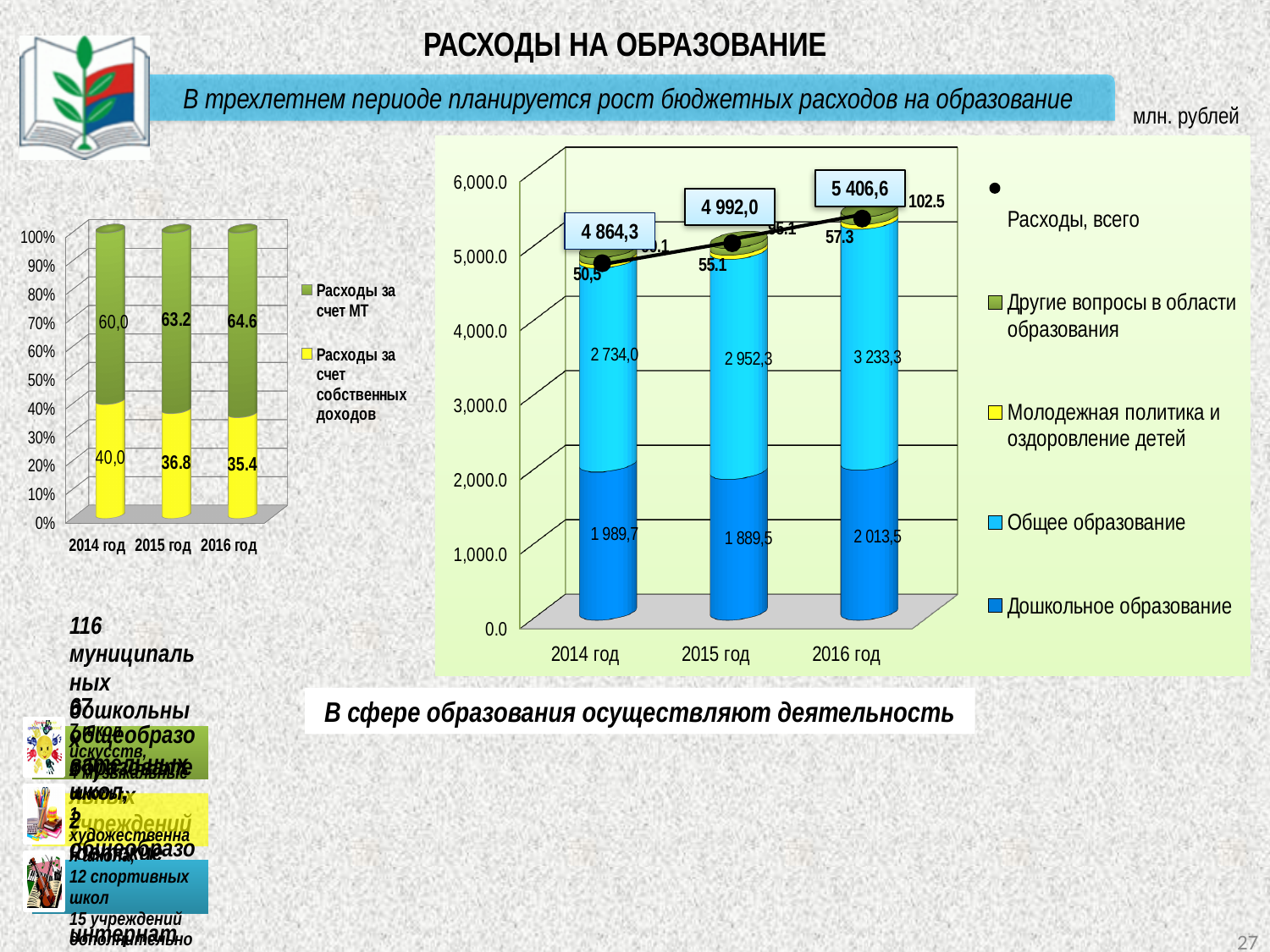
On the right chart, which year has the highest value of 'Расходы, всего'? 2016 год On the right chart, is 'Общее образование' larger in 2016 год or in 2014 год? 2016 год On the left chart, what is the value of 'Расходы за счет собственных доходов' for 2016 год? 35.4 On the right chart, what is the value for 'Дошкольное образование' in 2014 год? 1 989,7 How many series does the legend of the right chart list? 5 On the right chart, what is the value of 'Расходы, всего' for 2016 год? 5 406,6 On the left chart, what is the value of 'Расходы за счет МТ' for 2015 год? 63.2 On the right chart, does 'Расходы, всего' rise or fall from 2014 год to 2016 год? rise On the right chart, what is the value for 'Общее образование' in 2015 год? 2 952,3 What kind of chart is the left chart? bar chart On the right chart, which year has the lowest value for 'Дошкольное образование'? 2015 год On the left chart, which year has the highest share of 'Расходы за счет собственных доходов'? 2014 год